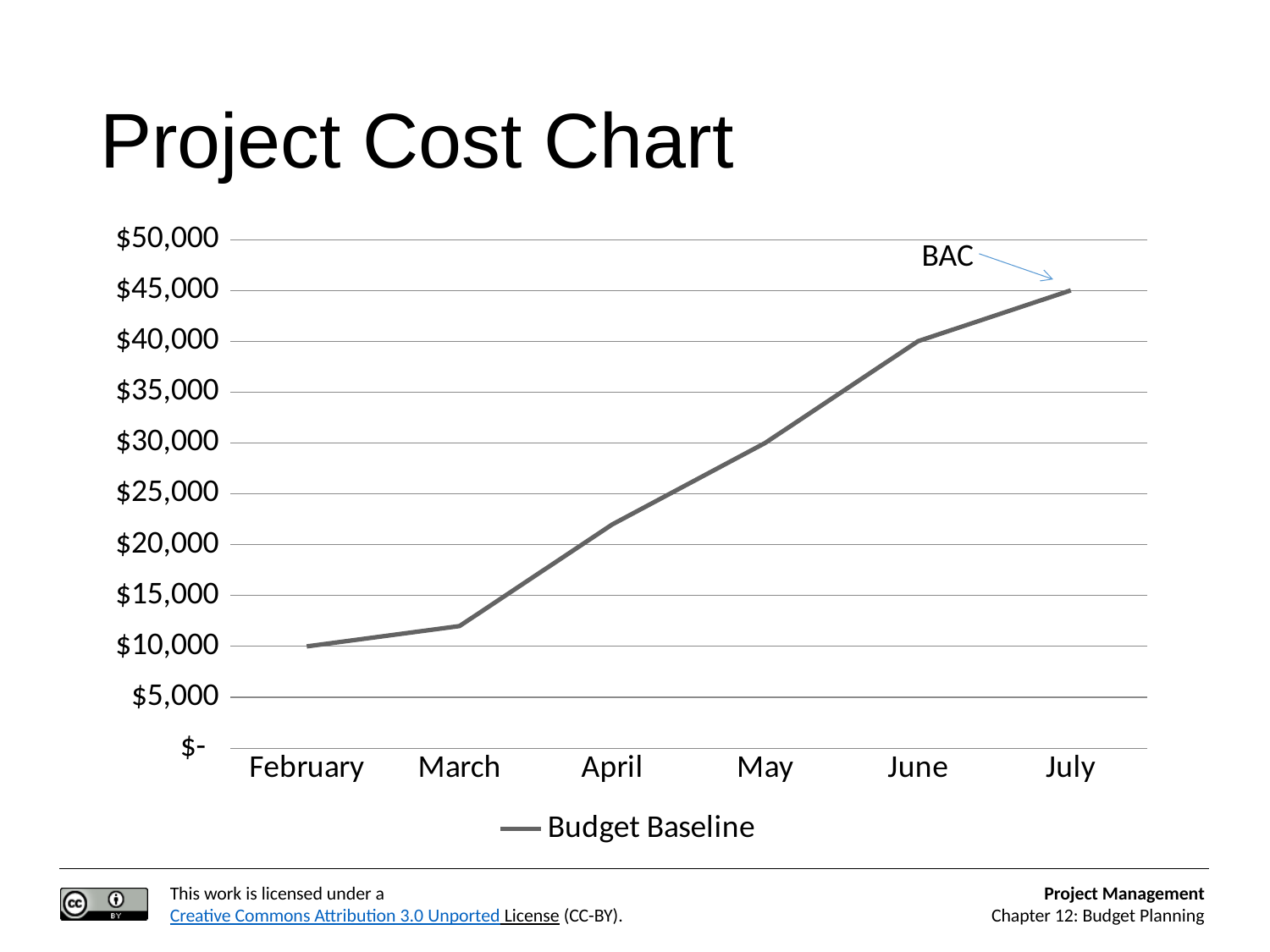
Which month has the highest Budget Baseline value? July What is the Budget Baseline value for July? $45,000 What type of chart is shown on the slide? Line chart What is the difference between the Budget Baseline values for July and February? $35,000 Does the Budget Baseline rise or fall from February to July? Rise What is the Budget Baseline value for February? $10,000 What is the title of the chart? Project Cost Chart How many series does the legend list? 1 What is the Budget Baseline value for June? $40,000 Which month has the lowest Budget Baseline value? February Is the Budget Baseline value for April greater or less than $25,000? less How many months are plotted on the x axis? 6